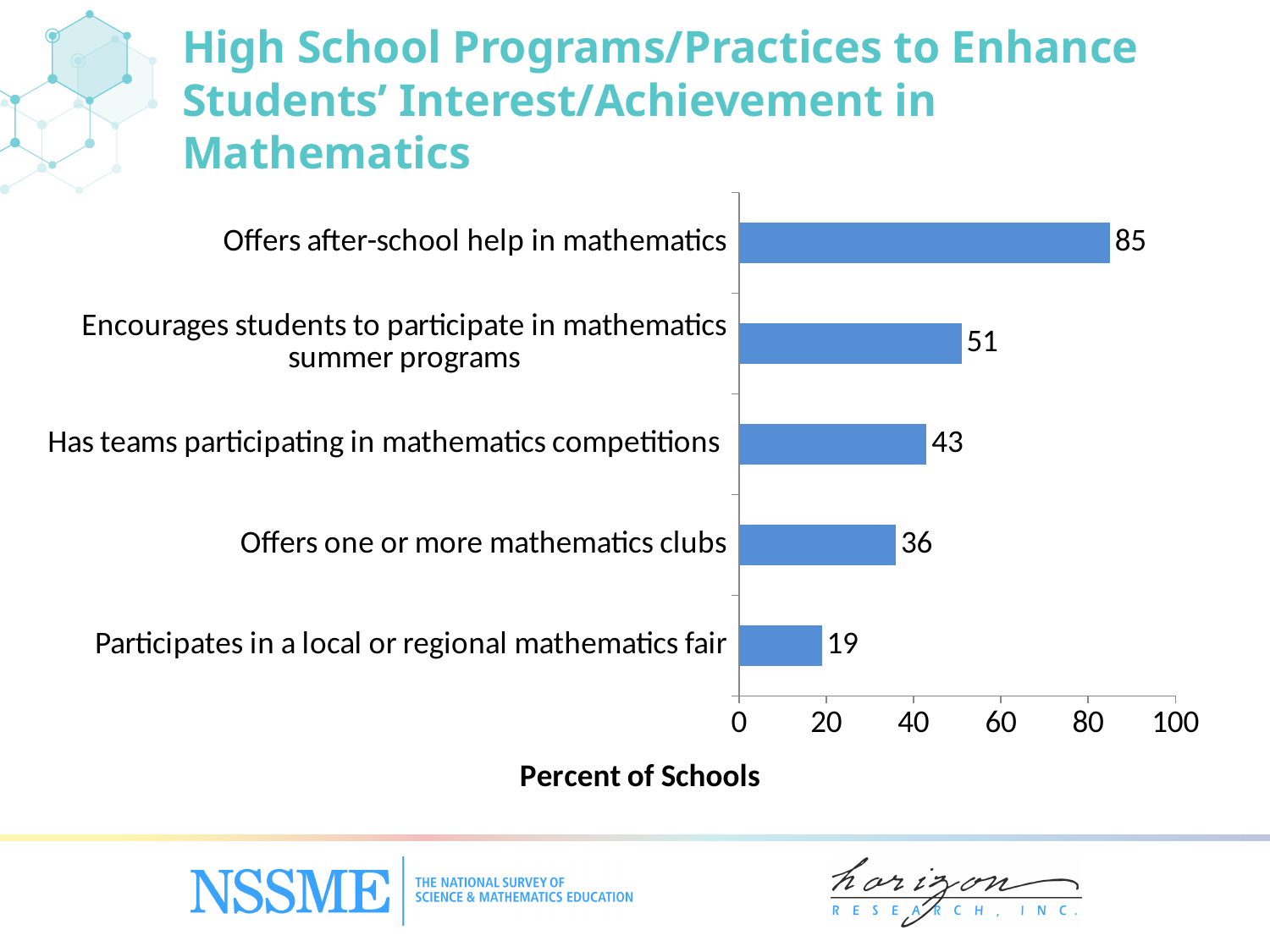
What is the label of the horizontal axis? Percent of Schools Which program/practice has the highest percent of schools? Offers after-school help in mathematics What percent of schools offer one or more mathematics clubs? 36 What percent of schools participate in a local or regional mathematics fair? 19 What percent of schools encourage students to participate in mathematics summer programs? 51 Which is larger: the percent of schools with teams participating in mathematics competitions or the percent offering one or more mathematics clubs? Has teams participating in mathematics competitions What kind of chart is shown on the slide? Bar chart What percent of schools have teams participating in mathematics competitions? 43 What is the difference in percent of schools between offering after-school help in mathematics and offering one or more mathematics clubs? 49 What percent of schools offer after-school help in mathematics? 85 Which program/practice has the lowest percent of schools? Participates in a local or regional mathematics fair How many programs/practices are shown in the chart? 5